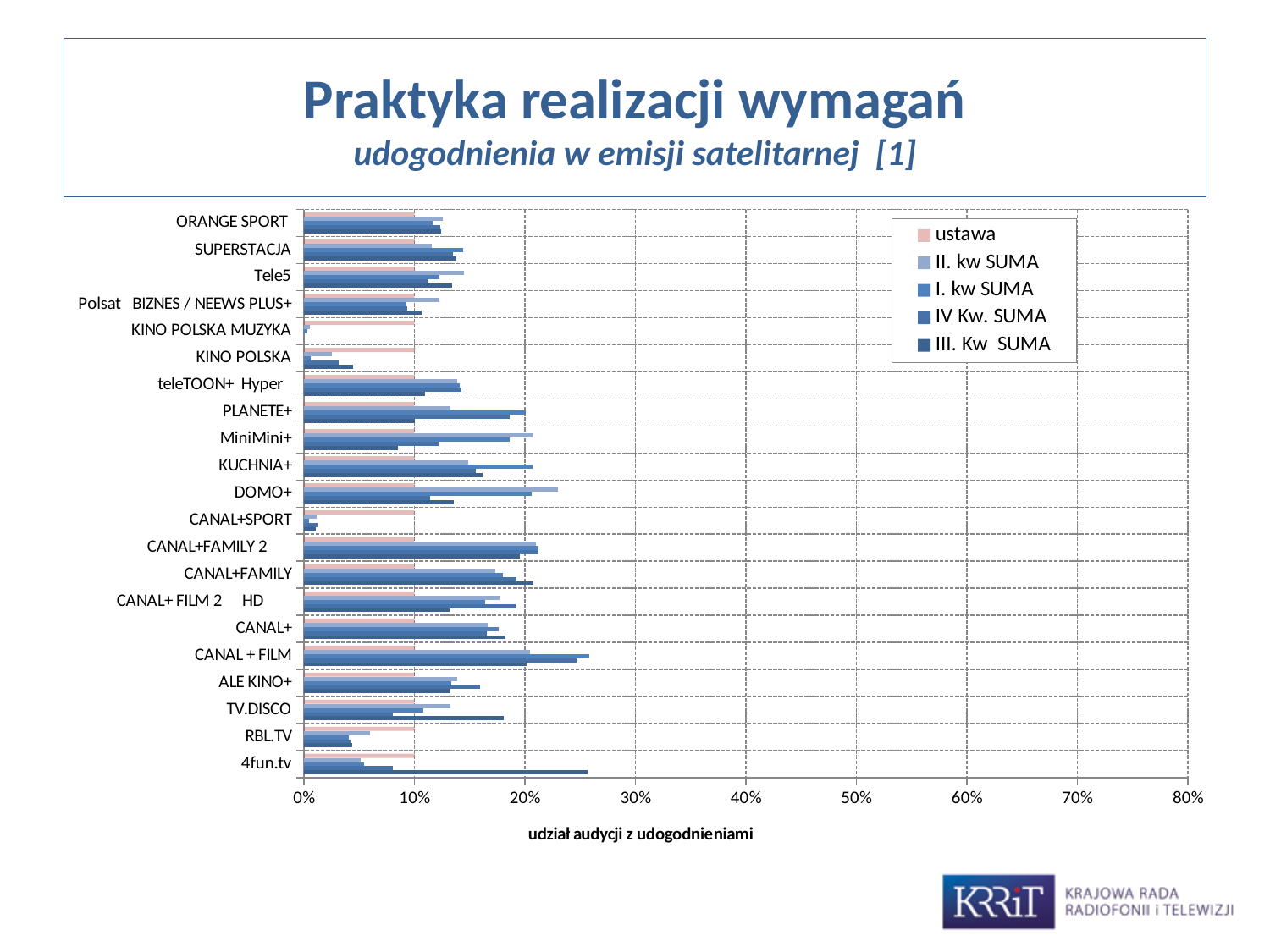
How many channels (categories) are plotted on the chart? 21 Is the II. kw SUMA value for DOMO+ greater or less than 20%? greater Which channel has the lowest III. Kw SUMA value? KINO POLSKA MUZYKA Which channel has the highest II. kw SUMA value? DOMO+ Is the II. kw SUMA value for CANAL+SPORT greater or less than 10%? less Is the III. Kw SUMA value for 4fun.tv greater or less than 20%? greater Which series is listed first in the legend? ustawa What is the ustawa value for ORANGE SPORT? 10% How many series does the legend list? 5 What kind of chart is shown on the slide? bar chart What is the title of the horizontal axis? udział audycji z udogodnieniami For DOMO+, which is larger: the II. kw SUMA value or the III. Kw SUMA value? II. kw SUMA